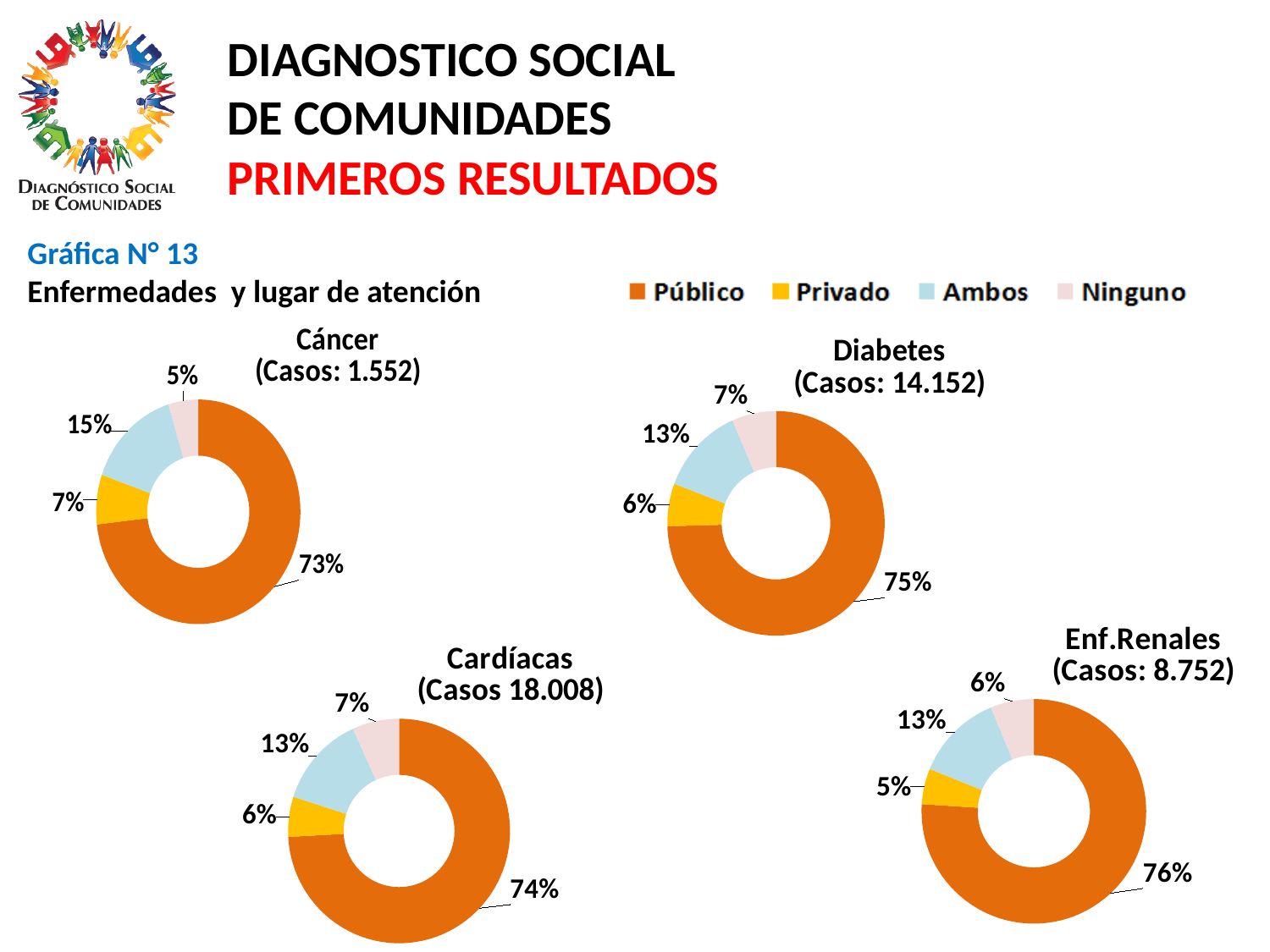
In the Enf.Renales chart, which category has the smallest share? Privado In the Enf.Renales chart, what percentage corresponds to Privado? 5% What type of chart is used for Diabetes? Donut (pie) chart In the Cáncer chart, which category has the largest share? Público How many categories does each donut chart show? 4 In the Cáncer chart, what share of cases is attended in the Público sector? 73% Which is larger: the Público share in the Enf.Renales chart or the Público share in the Cáncer chart? Enf.Renales How many entries does the legend list? 4 How many cases are reported in the title of the Cardíacas chart? 18.008 In the Cáncer chart, what is the difference between the Ambos share and the Privado share? 8% In the Cardíacas chart, what percentage corresponds to Ninguno? 7% In the Diabetes chart, what percentage corresponds to Ambos? 13%